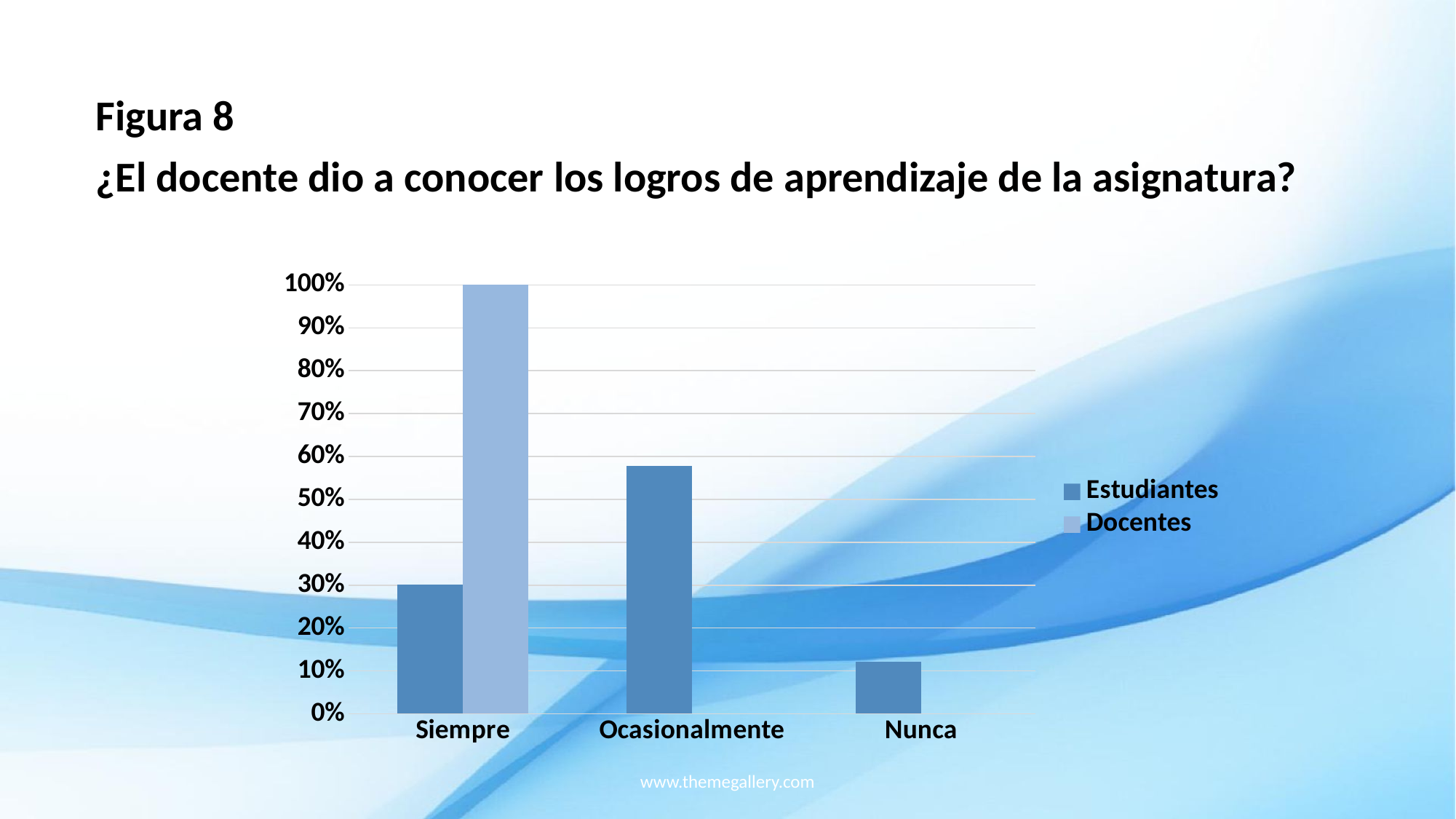
Is the value for Estudiantes in the Nunca category greater or less than 20%? less How many series does the legend list? 2 Which category has the lowest value for Estudiantes? Nunca Is the value for Estudiantes in the Ocasionalmente category greater or less than 50%? greater In the Siempre category, which series has the larger value, Estudiantes or Docentes? Docentes What are the two entries listed in the legend? Estudiantes, Docentes Which category has the highest value for Estudiantes? Ocasionalmente What type of chart is shown on the slide? bar chart What figure number is given in the slide title? Figura 8 What is the value for Docentes in the Siempre category? 100% How many categories are shown on the x axis? 3